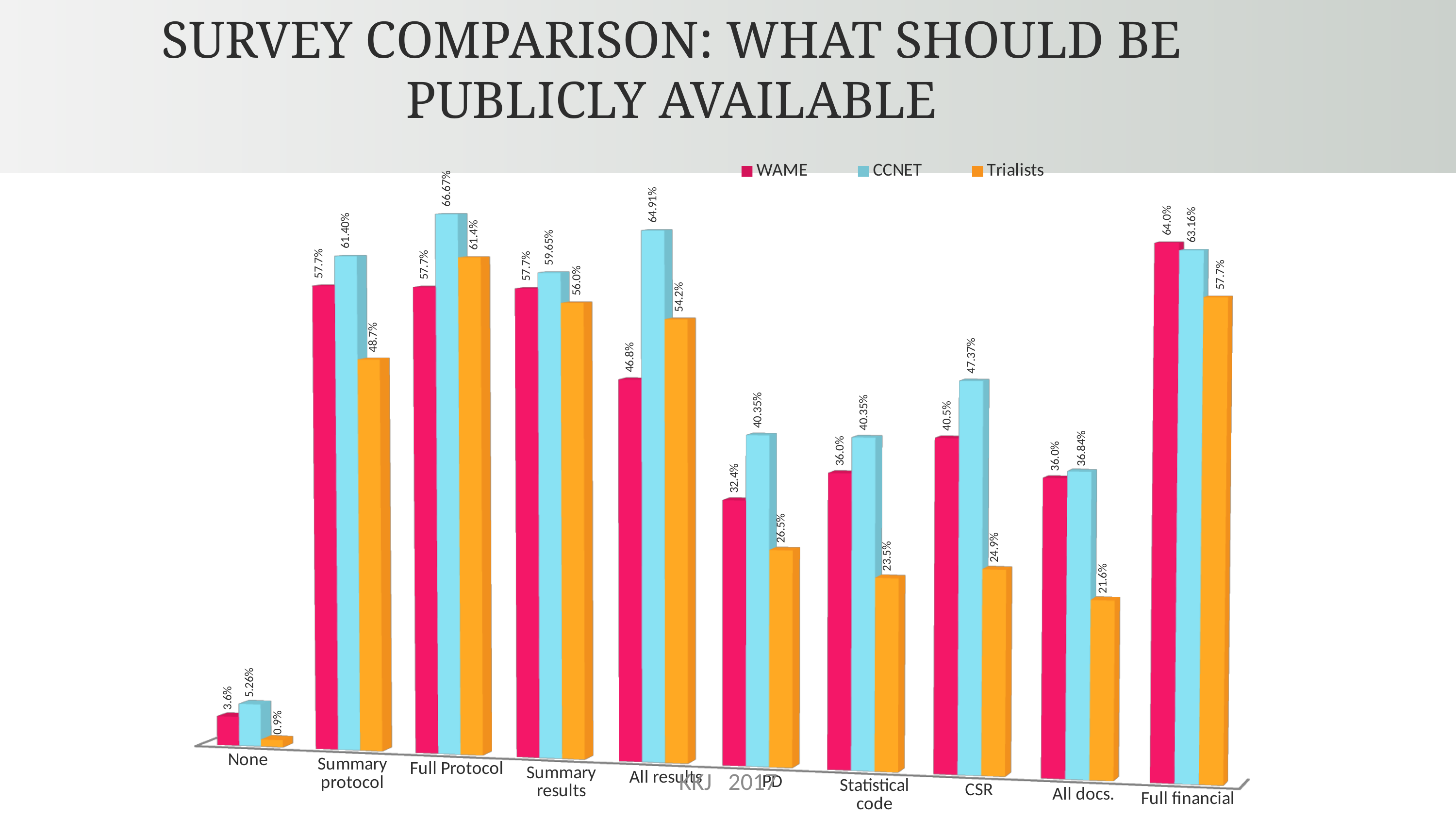
What kind of chart is shown on the slide? Bar chart What is the Trialists value for None? 0.9% How many series does the legend list? 3 How many categories are shown along the x axis? 10 For CSR, which is larger: the WAME value or the Trialists value? WAME Which category has the lowest Trialists value? None Which category has the highest WAME value? Full financial What colour are the Trialists bars? Orange What is the WAME value for Full financial? 64.0% For Full Protocol, what is the difference between the CCNET and WAME values? 8.97% What is the CCNET value for Full Protocol? 66.67% Which category has the highest CCNET value? Full Protocol